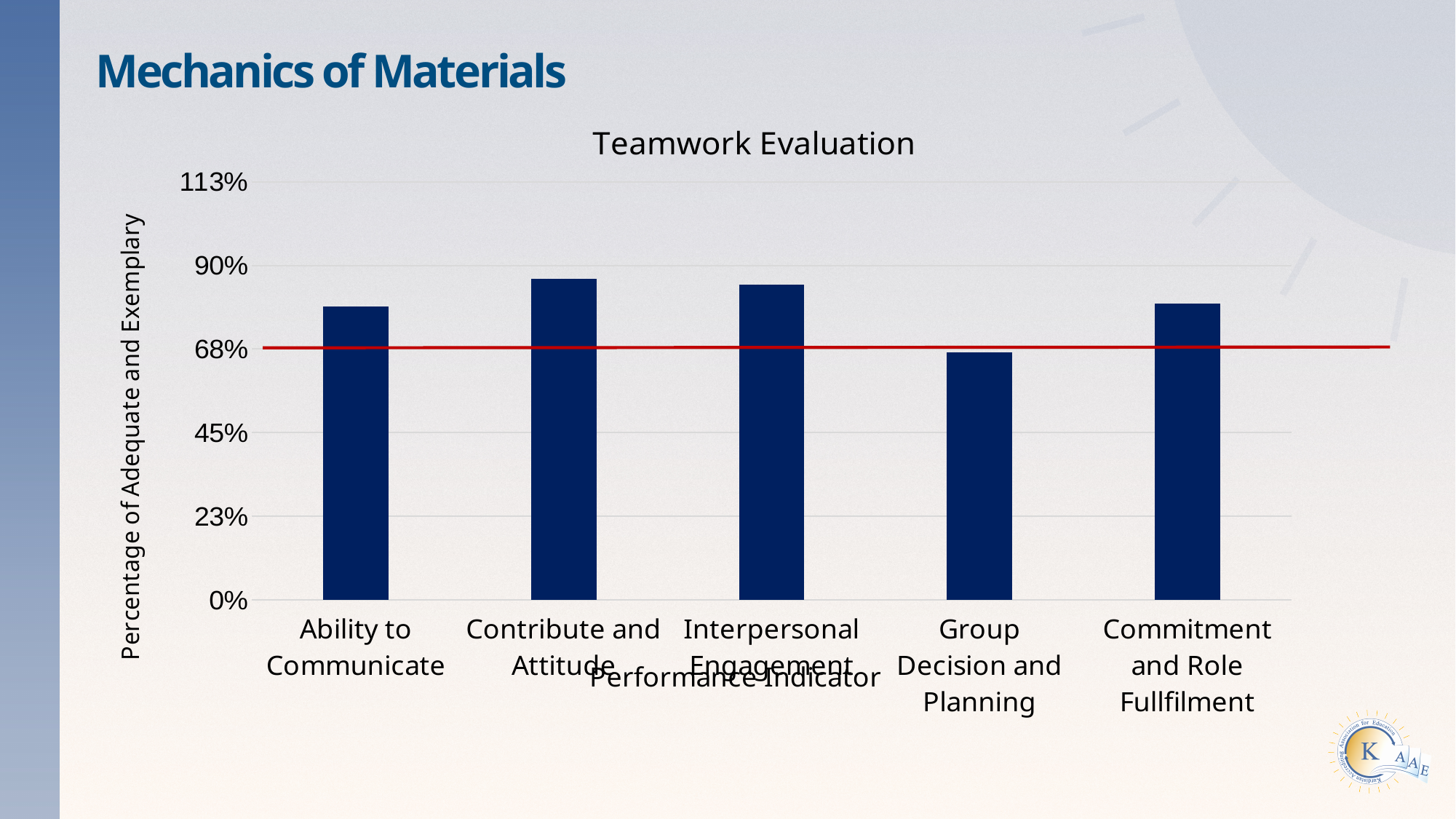
Which performance indicator has the lowest bar? Group Decision and Planning What type of chart is shown on the slide? Bar chart What is the title of the chart? Teamwork Evaluation Is the value for Commitment and Role Fullfilment greater or less than 90%? less Is the value for Group Decision and Planning greater or less than 45%? greater What is the label of the y axis? Percentage of Adequate and Exemplary How many performance indicators are plotted on the x axis? 5 Which is larger, the value for Interpersonal Engagement or the value for Ability to Communicate? Interpersonal Engagement Which is larger, the value for Contribute and Attitude or the value for Group Decision and Planning? Contribute and Attitude Is the value for Ability to Communicate greater or less than 68%? greater